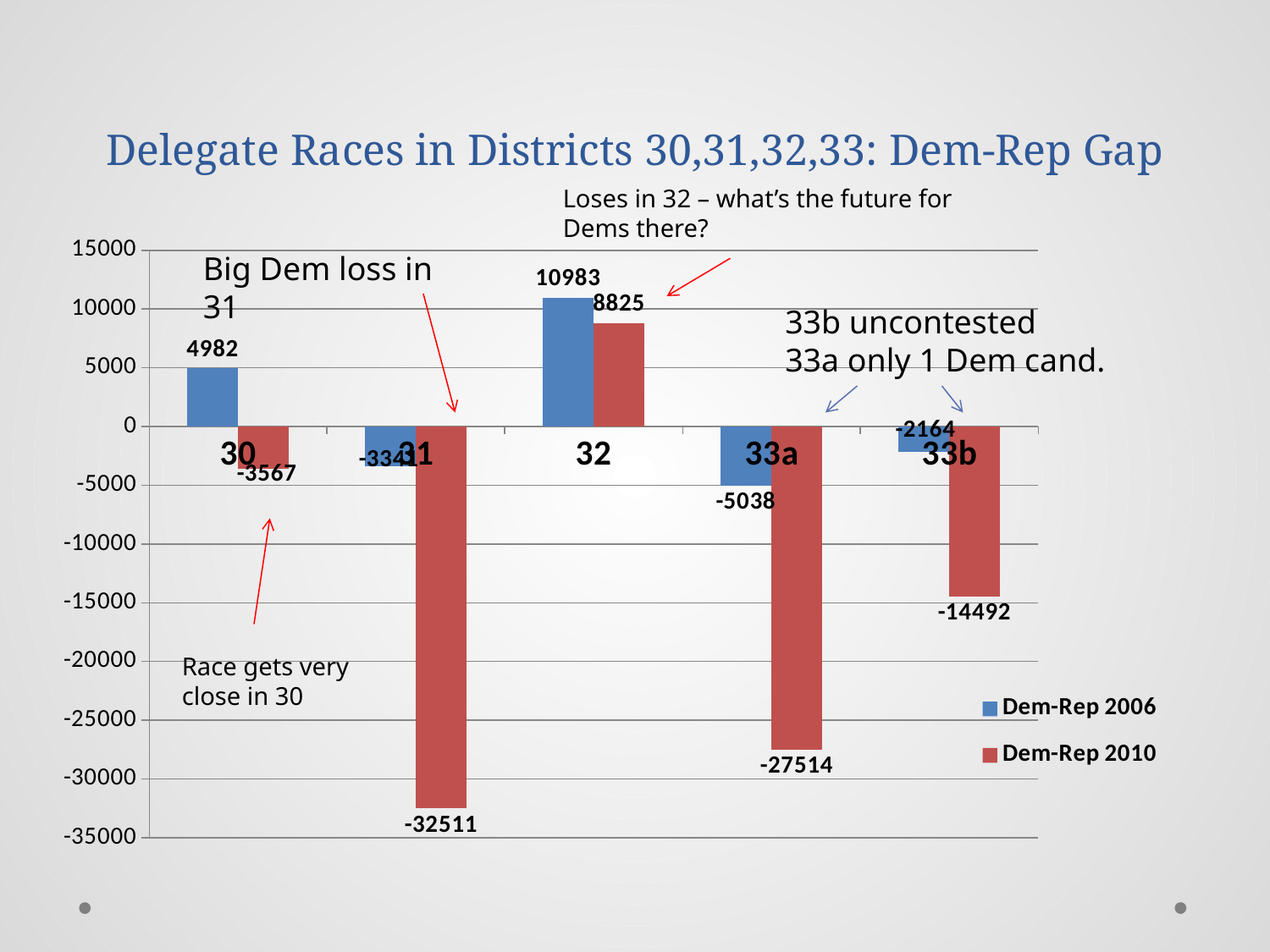
How many districts are shown on the x axis? 5 What is the Dem-Rep 2006 value for district 33b? -2164 What is the Dem-Rep 2010 value for district 31? -32511 Is the Dem-Rep 2010 value for district 33a greater or less than -25000? less What is the difference between the Dem-Rep 2006 and Dem-Rep 2010 values for district 32? 2158 Which is larger for district 33b: the Dem-Rep 2006 value or the Dem-Rep 2010 value? Dem-Rep 2006 What kind of chart is shown on the slide? bar chart Which district has the lowest Dem-Rep 2010 value? 31 What is the Dem-Rep 2006 value for district 30? 4982 How many series does the legend list? 2 Which district has the highest Dem-Rep 2006 value? 32 What is the Dem-Rep 2010 value for district 33a? -27514